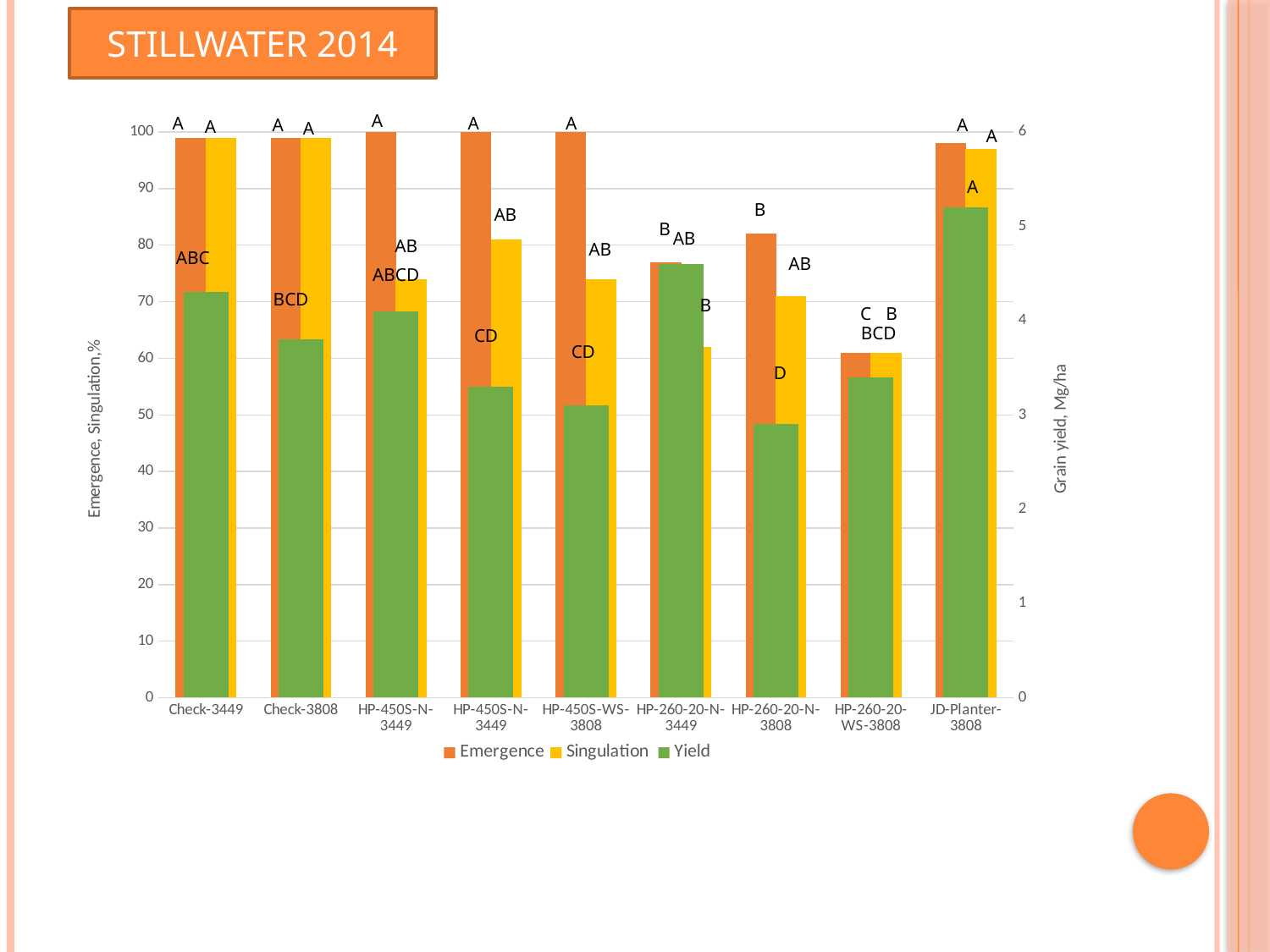
How many categories are shown along the x axis? 9 Is the Singulation value for HP-260-20-WS-3808 greater or less than 70? less Which category has the highest Yield? JD-Planter-3808 Is the Yield value for JD-Planter-3808 greater or less than 5 Mg/ha? greater What is the title of the slide containing the chart? STILLWATER 2014 Which category has the lowest Yield? HP-260-20-N-3808 Which is larger for HP-260-20-N-3808: Emergence or Singulation? Emergence How many series does the legend list? 3 What kind of chart is shown on the slide? bar chart Which category has the lowest Emergence? HP-260-20-WS-3808 Which category has a higher Yield: Check-3449 or HP-450S-WS-3808? Check-3449 Is the Emergence value for HP-260-20-N-3808 greater or less than 80? greater